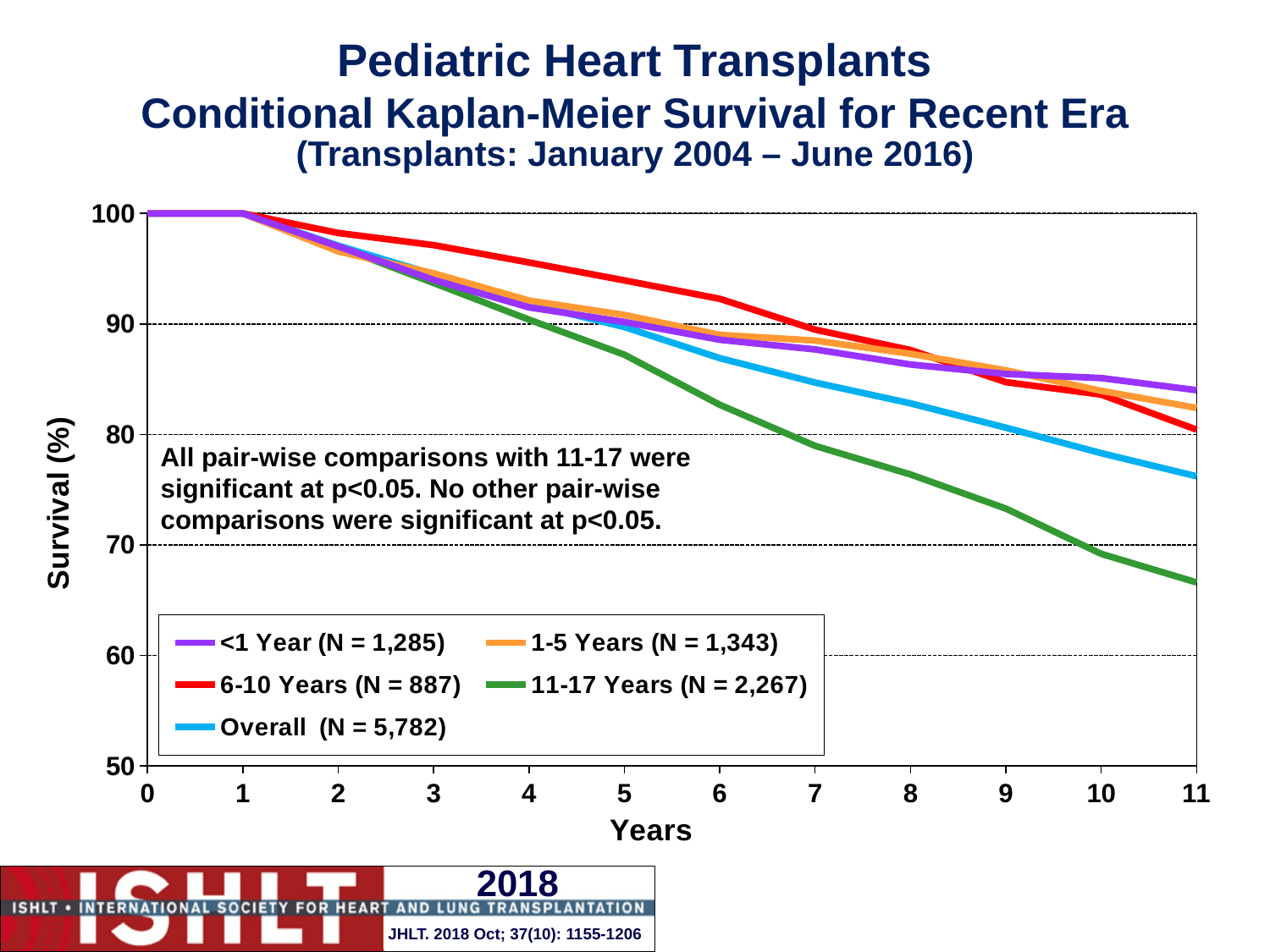
What is the survival value for all groups at year 0? 100 Is the survival value for <1 Year at year 11 greater or less than 80? greater Is the survival value for 6-10 Years at year 5 greater or less than 90? greater What kind of chart is shown on the slide? line chart Which group has the lowest survival at year 11? 11-17 Years Is the survival value for 11-17 Years at year 11 greater or less than 70? less Which group has the highest survival at year 5? 6-10 Years What is the N for the Overall group shown in the legend? 5,782 How many series does the legend list? 5 Do the survival curves rise or fall as years increase? fall At year 11, which is larger: the survival for Overall or for 11-17 Years? Overall